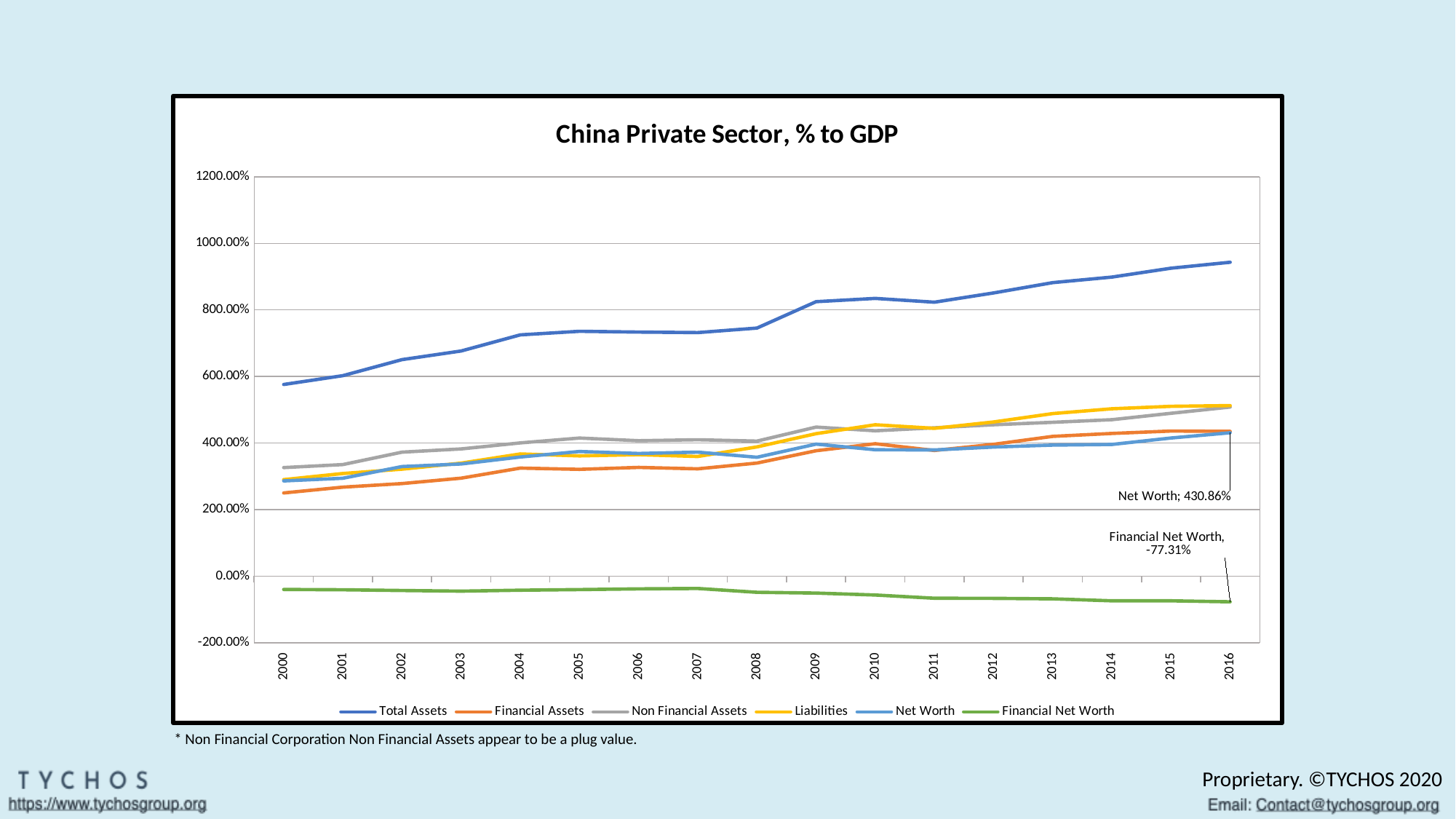
What is the difference between Net Worth and Financial Net Worth in 2016? 508.17% What is the value of Financial Net Worth in 2016? -77.31% Which is larger in 2016, Total Assets or Liabilities? Total Assets Which series has the lowest value across the chart? Financial Net Worth Does Total Assets rise or fall from 2000 to 2016? Rise How many years are shown on the x axis? 17 What is the title of the chart? China Private Sector, % to GDP What is the value of Net Worth in 2016? 430.86% How many series does the legend list? 6 Which series has the highest value in 2016? Total Assets Is the value for Total Assets in 2016 greater or less than 800.00%? greater What type of chart is shown on the slide? Line chart